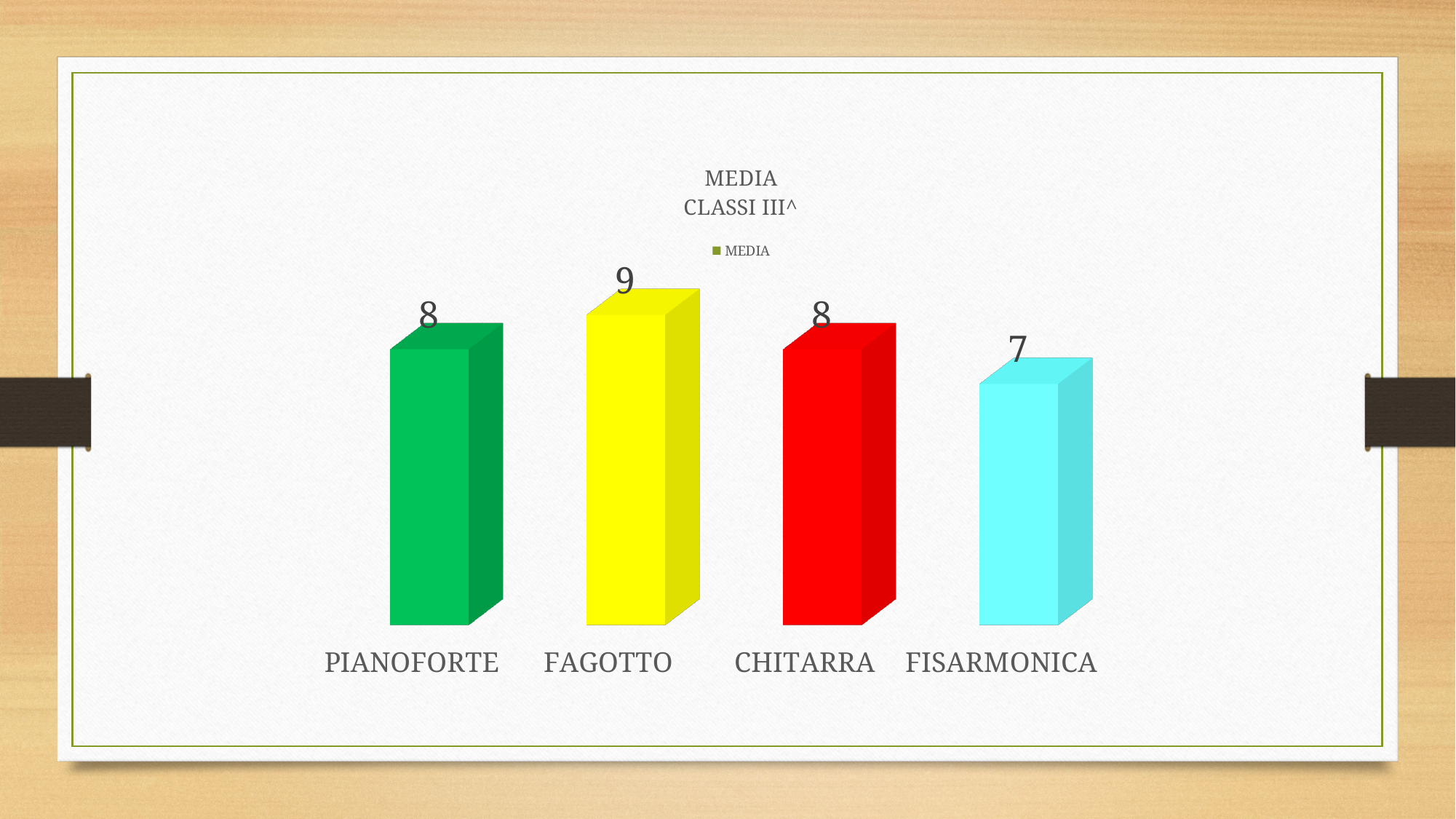
What is the value for CHITARRA? 8 How many series does the legend list? 1 Which category has the highest value? FAGOTTO What is the title of the chart? MEDIA CLASSI III^ What is the difference between the values for FAGOTTO and FISARMONICA? 2 Which is larger, the value for FAGOTTO or the value for CHITARRA? FAGOTTO What is the value for FISARMONICA? 7 What is the value for FAGOTTO? 9 Which category has the lowest value? FISARMONICA What is the value for PIANOFORTE? 8 What kind of chart is shown on the slide? bar chart How many categories are shown in the chart? 4